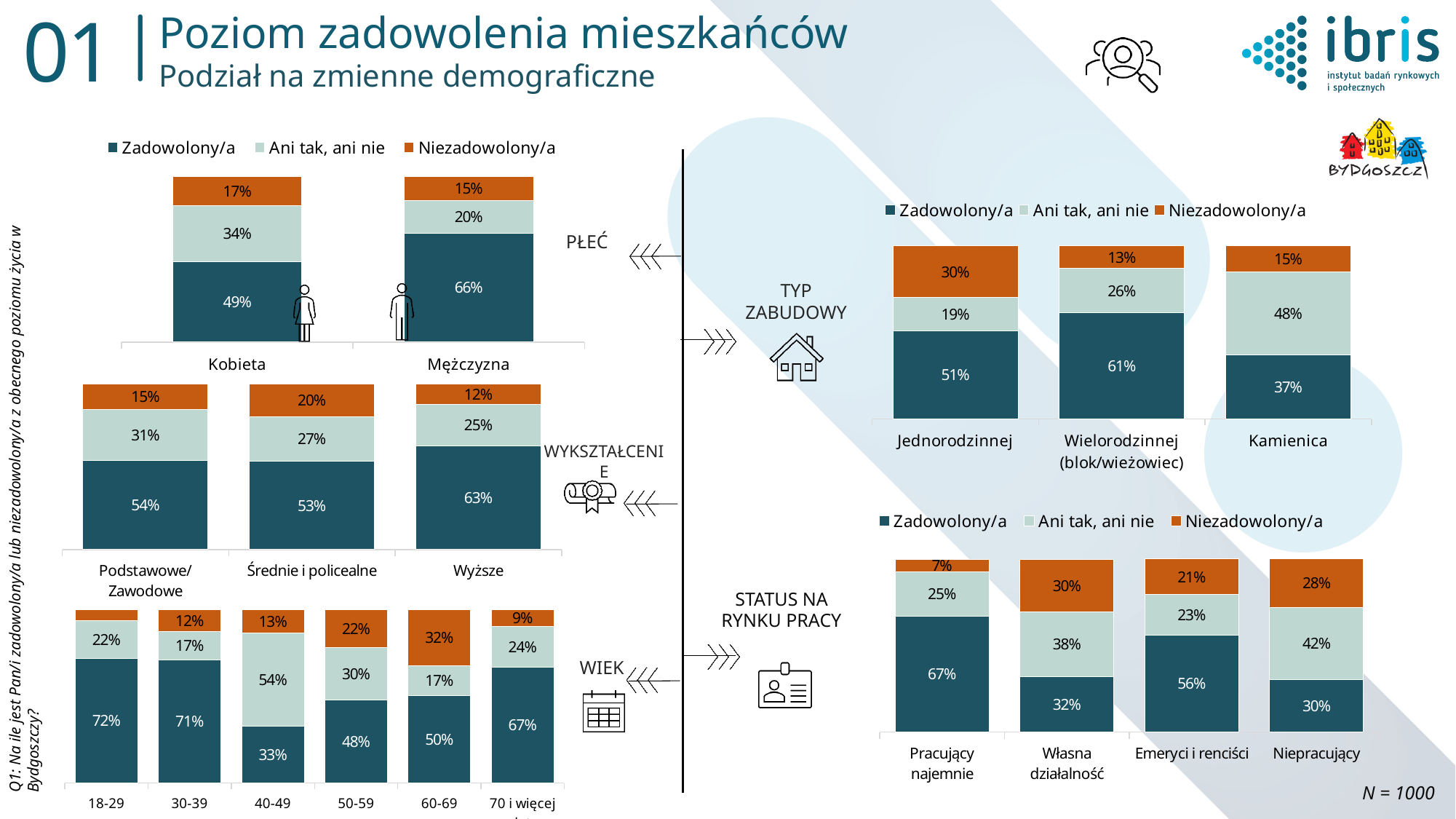
What type of chart is used for the PŁEĆ data? Stacked bar chart What sample size (N) is stated on the slide? N = 1000 In the PŁEĆ chart, what percentage of Mężczyzna respondents are Zadowolony/a? 66% In the TYP ZABUDOWY chart, which has a larger Ani tak, ani nie share: Kamienica or Wielorodzinnej (blok/wieżowiec)? Kamienica In the TYP ZABUDOWY chart, what is the Niezadowolony/a share for Jednorodzinnej? 30% In the PŁEĆ chart, what is the total of the stacked bar for Kobieta? 100% How many series does the legend of the STATUS NA RYNKU PRACY chart list? 3 In the WYKSZTAŁCENIE chart, what is the difference in Zadowolony/a share between Wyższe and Średnie i policealne? 10 percentage points How many age groups are shown in the WIEK chart? 6 In the WIEK chart, which age group has the lowest Zadowolony/a share? 40-49 In the STATUS NA RYNKU PRACY chart, which category has the highest Zadowolony/a share? Pracujący najemnie In the WIEK chart, what is the Niezadowolony/a value for the 60-69 age group? 32%